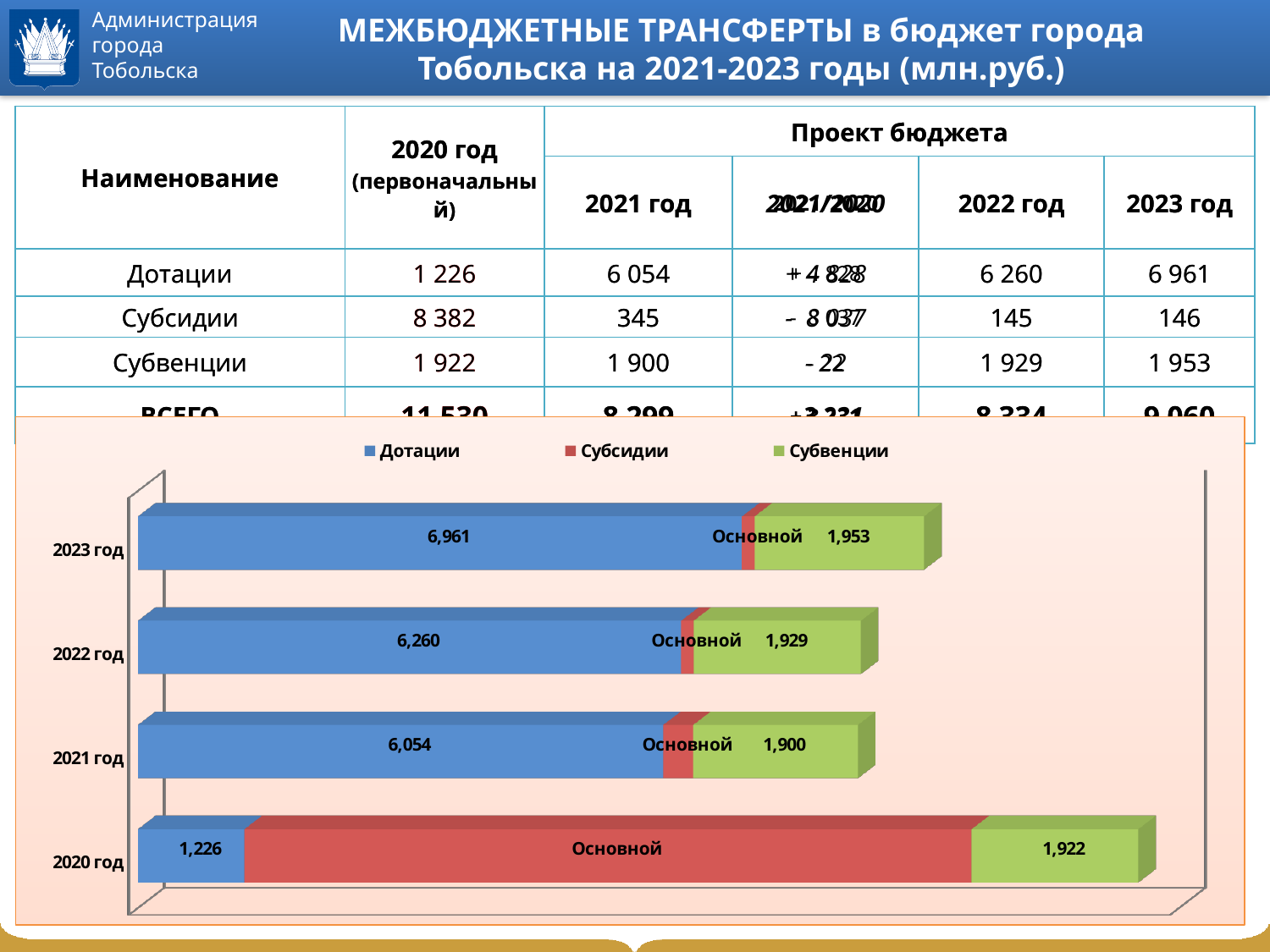
How many years (categories) are plotted in the chart? 4 What kind of chart is shown on the slide? stacked bar chart Which series is shown in red in the chart legend? Субсидии Which is larger in the chart: Субвенции for 2023 год or Субвенции for 2020 год? 2023 год What is the value of Дотации for 2023 год in the chart? 6,961 How many series does the chart legend list? 3 What is the value of Дотации for 2020 год in the chart? 1,226 What is the difference between the Дотации values for 2023 год and 2022 год in the chart? 701 What is the value of Субвенции for 2022 год in the chart? 1,929 What is the value of Субвенции for 2021 год in the chart? 1,900 Which year has the highest Дотации value in the chart? 2023 год Which year has the lowest Дотации value in the chart? 2020 год